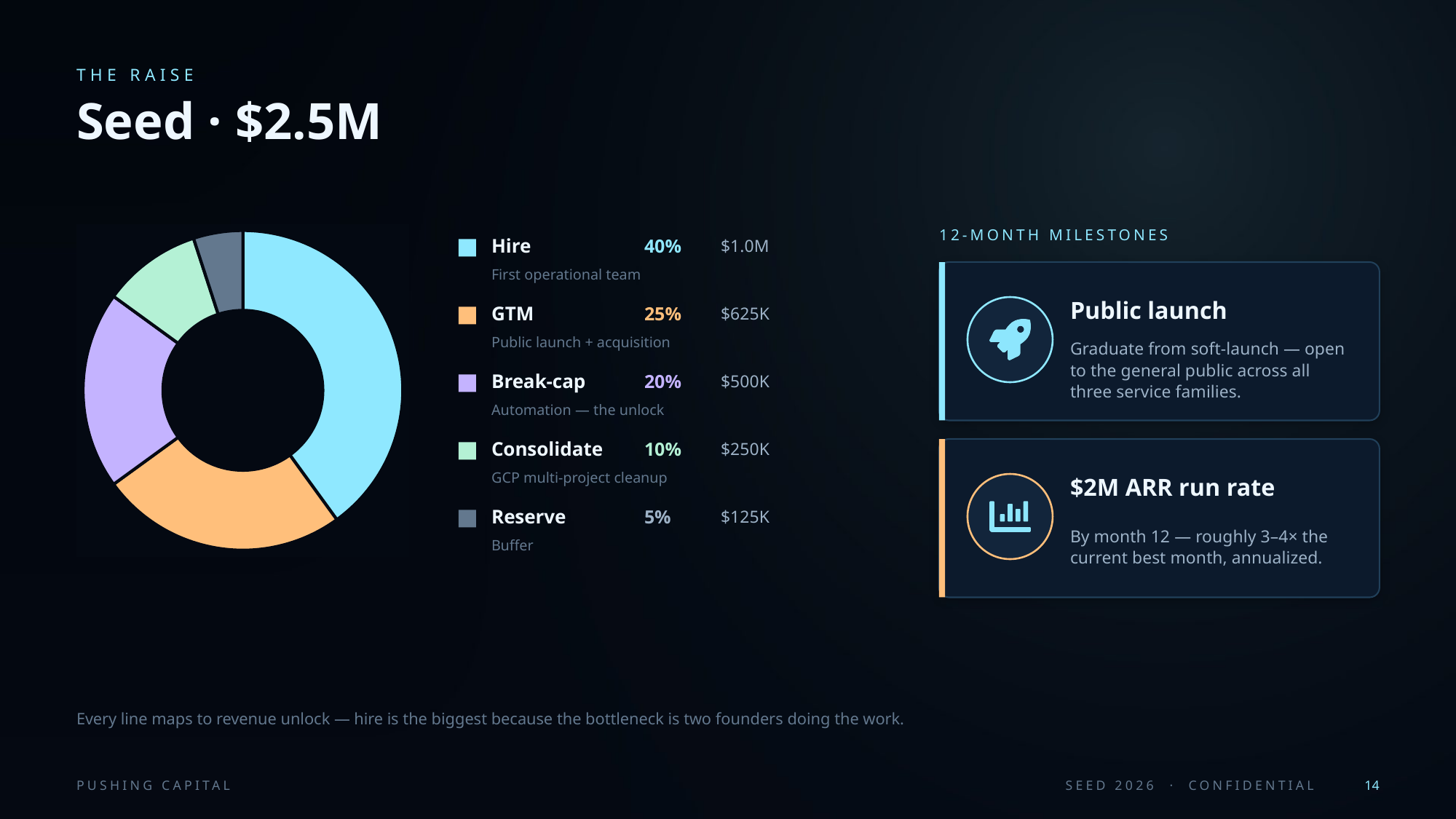
What share of the raise is allocated to Hire? 40% Which is larger, the allocation to Consolidate or to Reserve? Consolidate Which category receives the smallest share of the raise? Reserve What is the combined dollar amount of Consolidate and Reserve? $375K What colour represents the GTM slice in the donut chart? Orange Which category receives the largest share of the raise? Hire What dollar amount is allocated to Break-cap? $500K What is the difference in percentage points between the Hire and GTM shares? 15% How many categories does the donut chart show? 5 What dollar amount is allocated to GTM? $625K What kind of chart is shown on the slide? Donut (pie) chart What description is given under the Break-cap category? Automation — the unlock